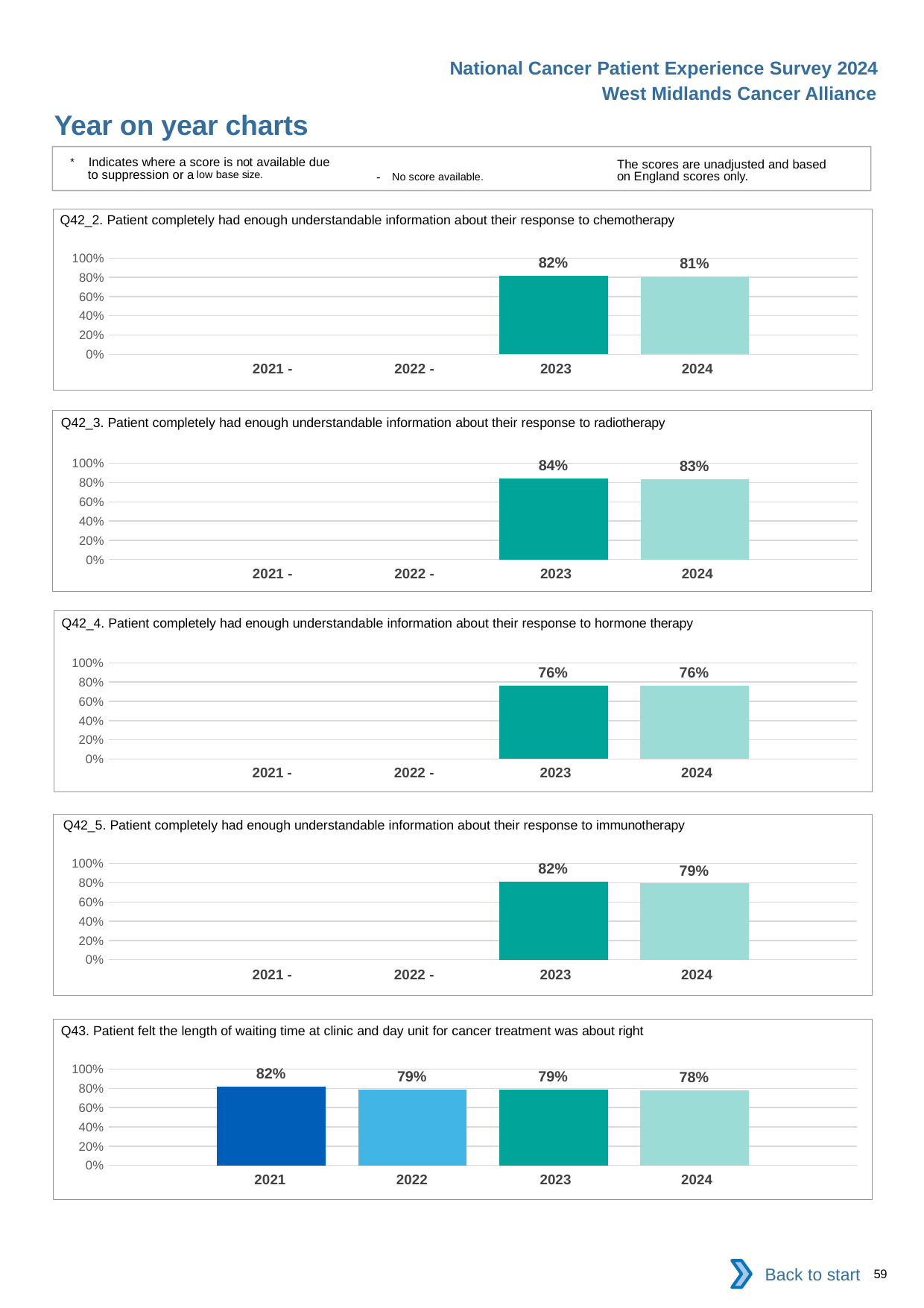
In the Q43 chart (waiting time at clinic and day unit), do the values rise or fall from 2021 to 2024? fall In the Q43 chart (waiting time at clinic and day unit), which year has the lowest value? 2024 In the Q43 chart (waiting time at clinic and day unit), what is the value for 2022? 79% In the Q43 chart (waiting time at clinic and day unit), how many years have a plotted bar? 4 In the Q42_2 chart (chemotherapy), what is the value for 2023? 82% In the Q42_4 chart (hormone therapy), what is the value for 2023? 76% In the Q42_3 chart (radiotherapy), what is the value for 2024? 83% What type of chart is the Q43 chart (waiting time at clinic and day unit)? bar chart In the Q42_3 chart (radiotherapy), is the 2023 value larger or smaller than the 2024 value? larger In the Q42_2 chart (chemotherapy), how many years have a plotted bar? 2 In the Q43 chart (waiting time at clinic and day unit), which year has the highest value? 2021 In the Q42_5 chart (immunotherapy), what is the difference between the 2023 and 2024 values? 3 percentage points